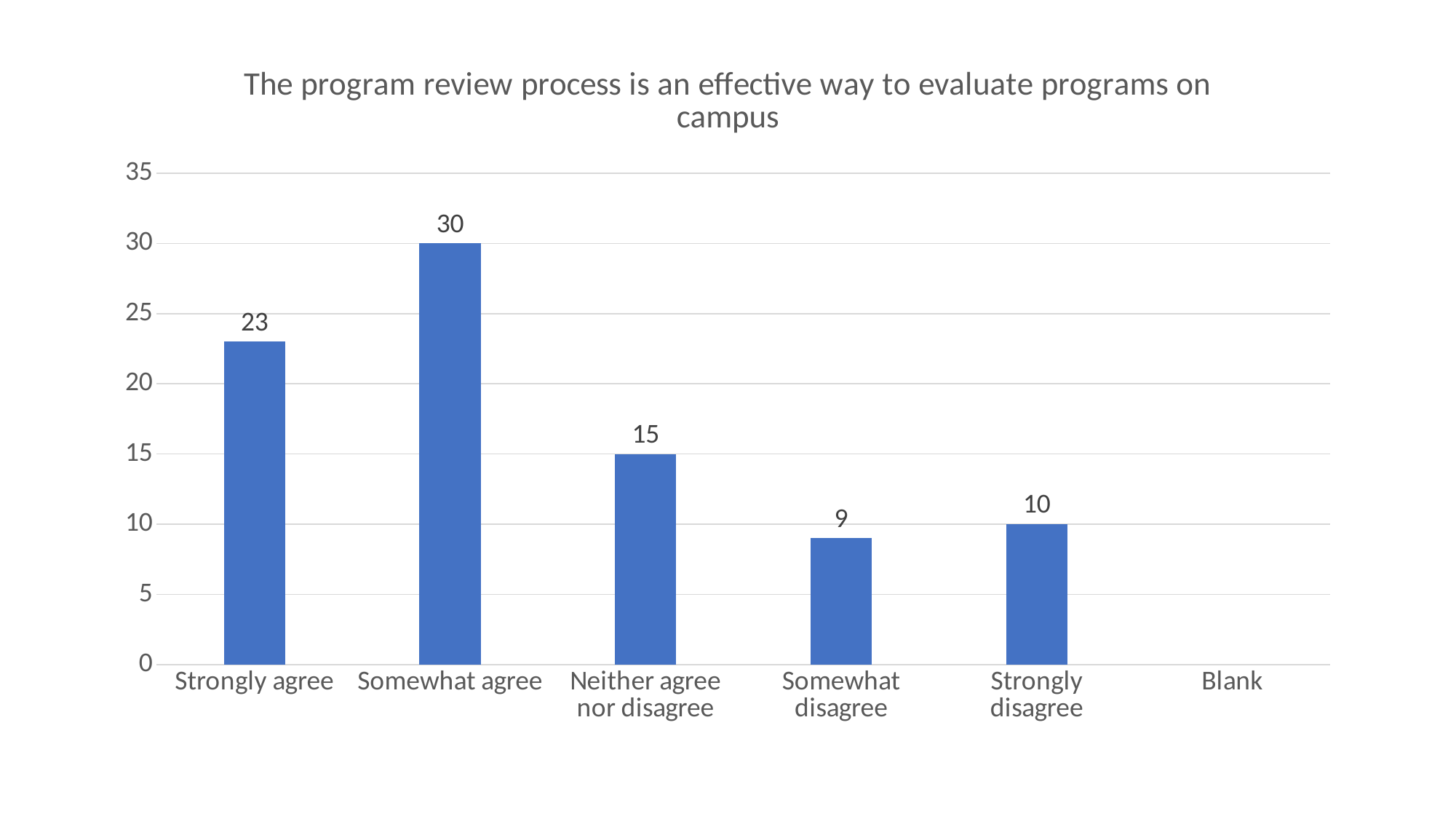
Which is larger, the value for Strongly disagree or the value for Somewhat disagree? Strongly disagree How many categories are shown on the x axis? 6 Which category with a visible bar has the lowest value? Somewhat disagree Is the value for Strongly agree greater or less than 20? greater What kind of chart is shown on the slide? Bar chart What is the difference between the values for Somewhat agree and Strongly agree? 7 What is the value for Somewhat agree? 30 Which category has the highest value? Somewhat agree What is the value for Neither agree nor disagree? 15 What is the value for Strongly agree? 23 What is the value for Somewhat disagree? 9 What is the title of the chart? The program review process is an effective way to evaluate programs on campus